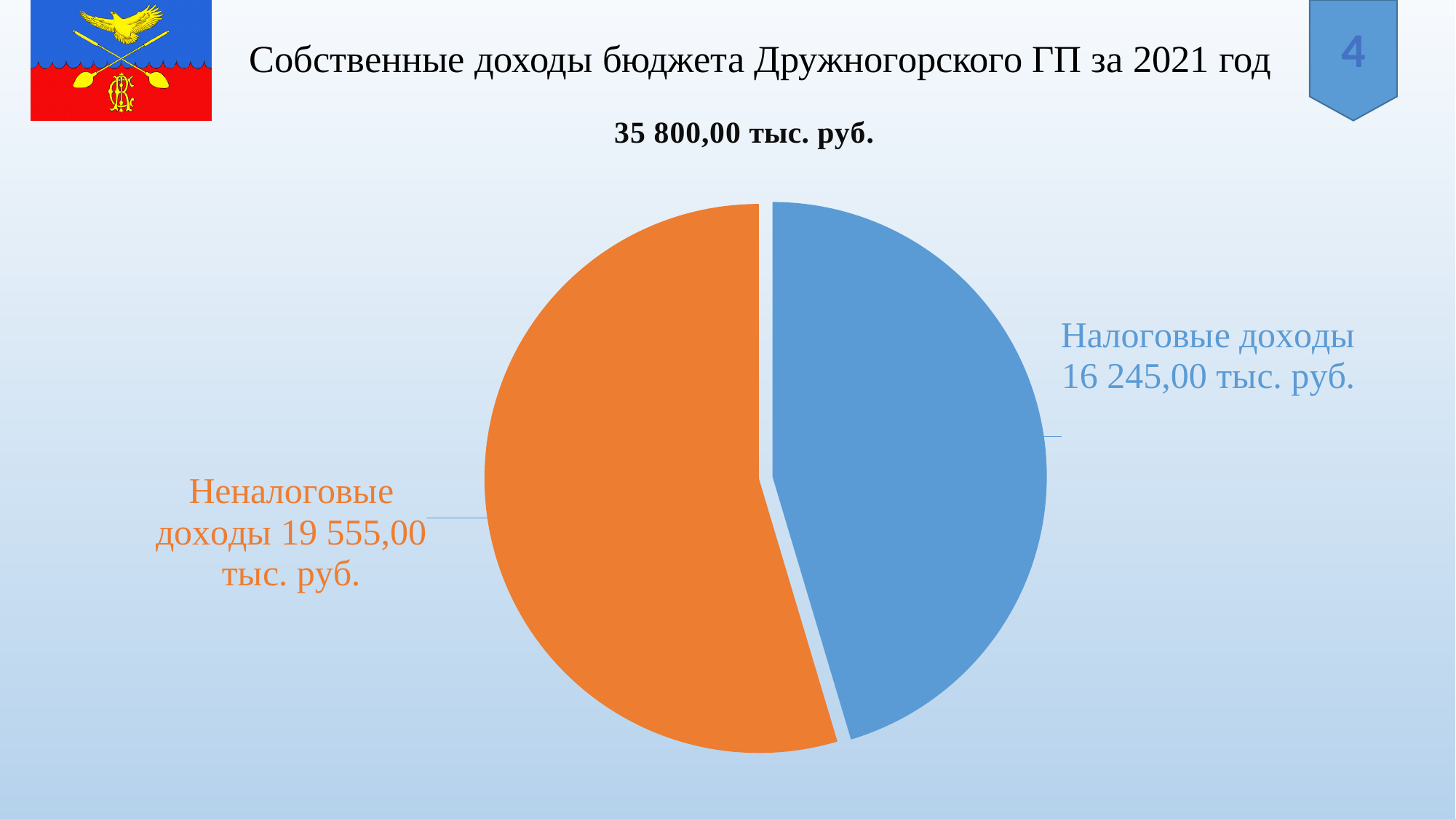
How many slices does the pie chart have? 2 What is the difference between Неналоговые доходы and Налоговые доходы? 3 310,00 тыс. руб. What is the title of the slide containing the chart? Собственные доходы бюджета Дружногорского ГП за 2021 год Which category has the smallest slice of the pie? Налоговые доходы What type of chart is shown on the slide? pie chart What is the total of the two slices shown on the slide? 35 800,00 тыс. руб. What colour is the slice for Налоговые доходы? blue Which is larger, Налоговые доходы or Неналоговые доходы? Неналоговые доходы What is the value for Налоговые доходы? 16 245,00 тыс. руб. What is the value for Неналоговые доходы? 19 555,00 тыс. руб. Which category has the largest slice of the pie? Неналоговые доходы